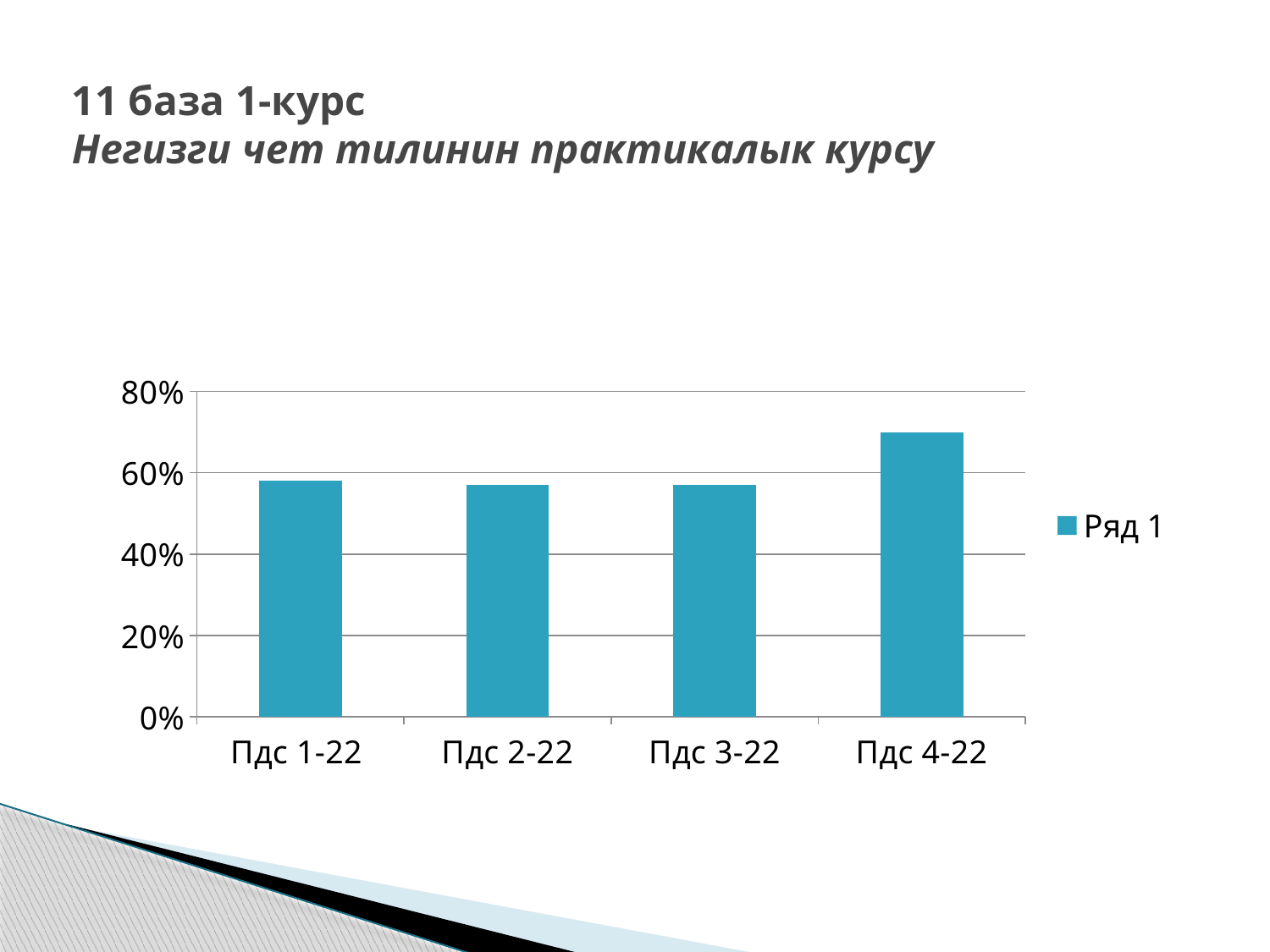
Which is larger, the value for Пдс 3-22 or the value for Пдс 4-22? Пдс 4-22 How many categories are shown on the x axis of the chart? 4 Is the value for Пдс 2-22 greater or less than 60%? less Is the value for Пдс 1-22 greater or less than 40%? greater How many series does the chart's legend list? 1 What is the highest value shown on the chart's y axis? 80% Is the value for Пдс 3-22 greater or less than 80%? less Which is larger, the value for Пдс 4-22 or the value for Пдс 2-22? Пдс 4-22 Which category has the highest bar in the chart? Пдс 4-22 What kind of chart is shown on the slide? bar chart What is the name of the series shown in the chart's legend? Ряд 1